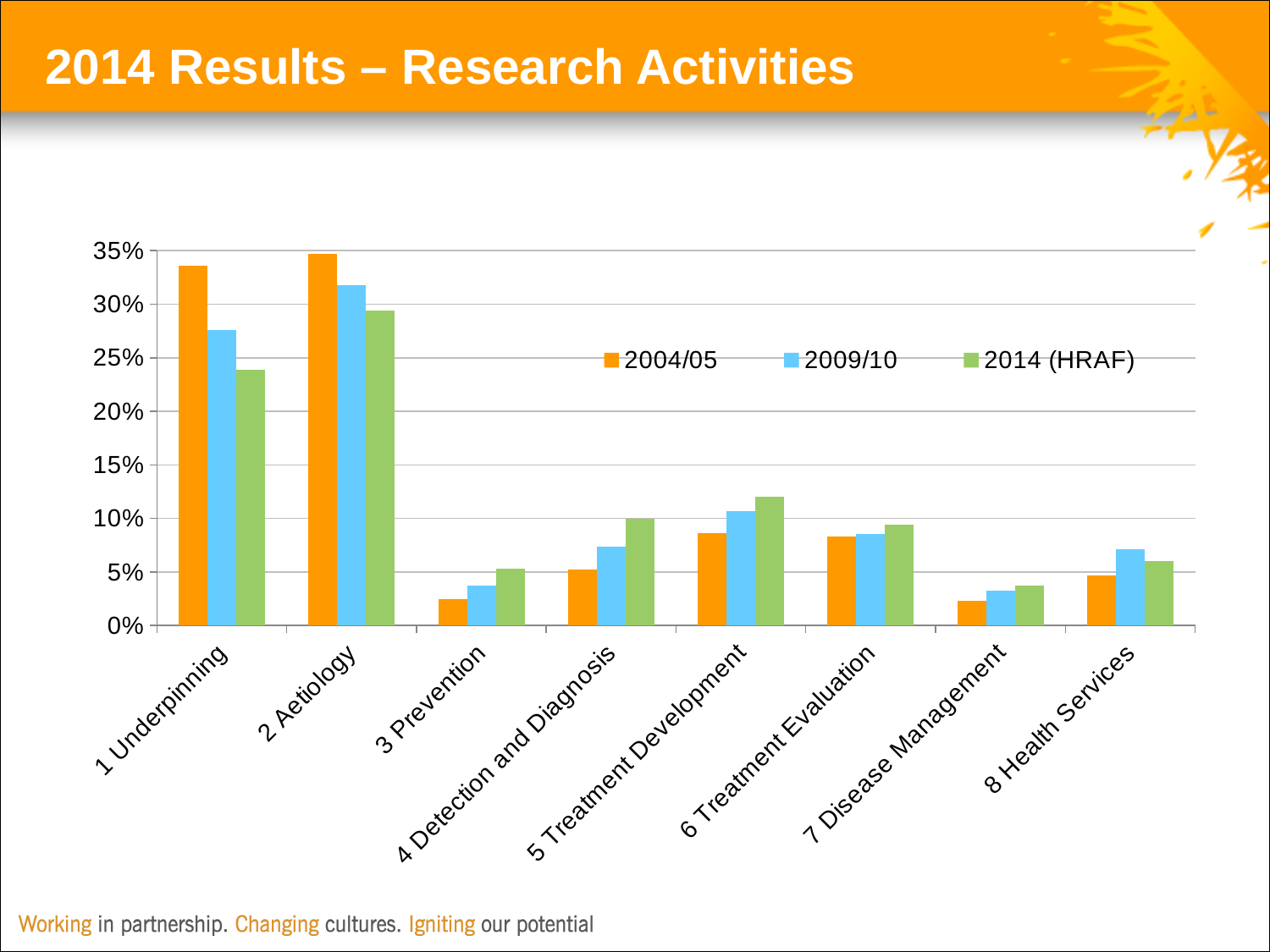
Is the 2014 (HRAF) value for 1 Underpinning greater or less than 30%? less How many series does the legend list? 3 Which category has the lowest value for the 2014 (HRAF) series? 7 Disease Management What colour represents the 2014 (HRAF) series in the legend? green Which category has the highest value for the 2004/05 series? 2 Aetiology How many research activity categories are shown on the x axis? 8 For 4 Detection and Diagnosis, which series has the larger value: 2004/05 or 2014 (HRAF)? 2014 (HRAF) What kind of chart is shown on the slide? bar chart Is the 2014 (HRAF) value for 5 Treatment Development greater or less than 10%? greater Is the 2004/05 value for 1 Underpinning greater or less than 30%? greater Which category has the highest value for the 2014 (HRAF) series? 2 Aetiology For 1 Underpinning, do the values rise or fall from 2004/05 through 2009/10 to 2014 (HRAF)? fall